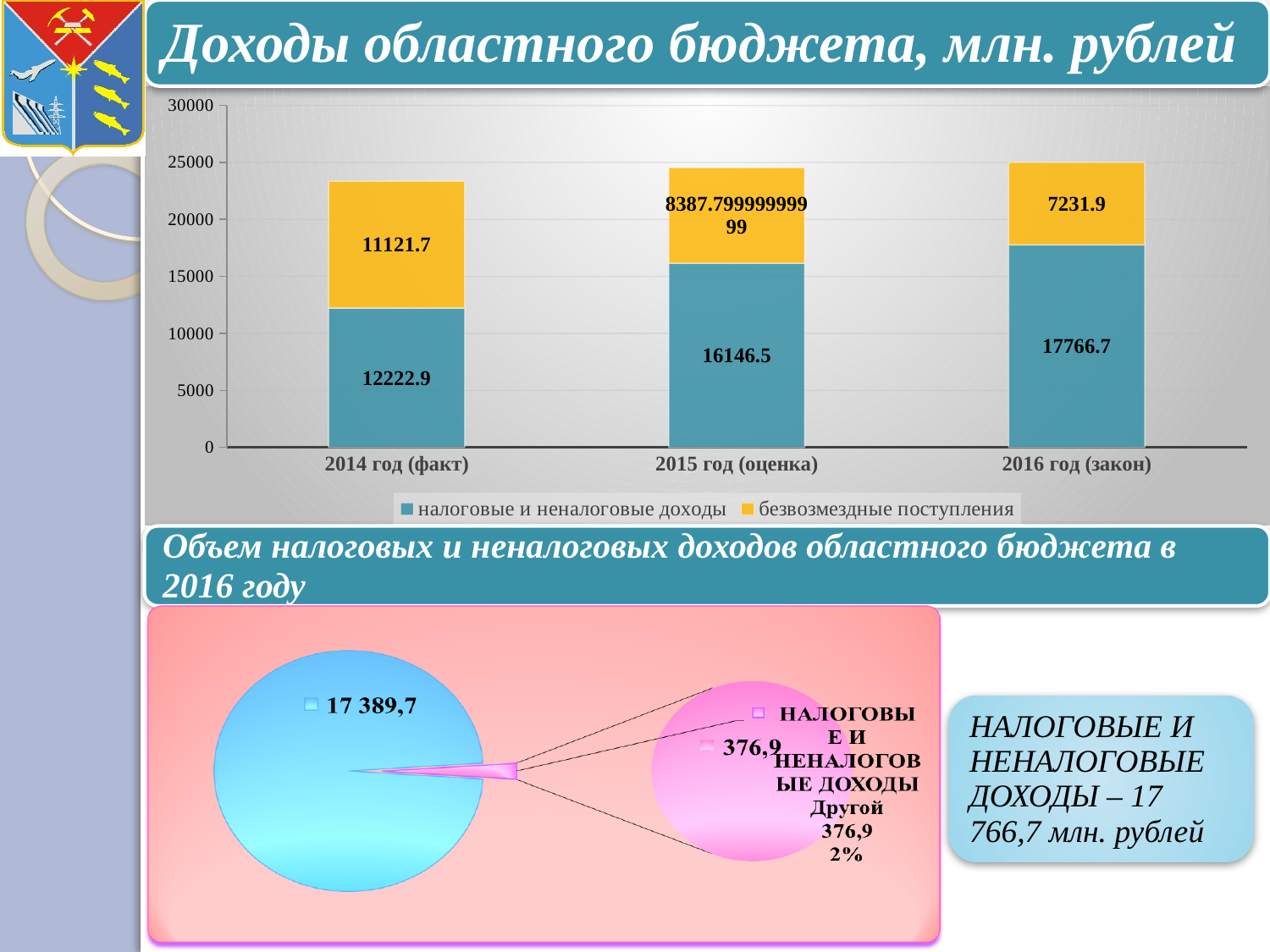
In the bar chart 'Доходы областного бюджета, млн. рублей', what is the value of безвозмездные поступления for 2016 год (закон)? 7231.9 In the pie chart 'Объем налоговых и неналоговых доходов областного бюджета в 2016 году', what share of the pie does the slice Другой represent? 2% In the bar chart 'Доходы областного бюджета, млн. рублей', what is the total of the stacked bar for 2014 год (факт)? 23344.6 In the bar chart 'Доходы областного бюджета, млн. рублей', how do the values of налоговые и неналоговые доходы change from 2014 to 2016? They rise In the bar chart 'Доходы областного бюджета, млн. рублей', what is the value of налоговые и неналоговые доходы for 2014 год (факт)? 12222.9 In the bar chart 'Доходы областного бюджета, млн. рублей', which year has the lowest value of безвозмездные поступления? 2016 год (закон) In the bar chart 'Доходы областного бюджета, млн. рублей', is безвозмездные поступления larger in 2014 год (факт) or in 2016 год (закон)? 2014 год (факт) How many series does the legend of the bar chart 'Доходы областного бюджета, млн. рублей' list? 2 In the pie chart 'Объем налоговых и неналоговых доходов областного бюджета в 2016 году', what is the value of the slice labelled Другой? 376,9 In the bar chart 'Доходы областного бюджета, млн. рублей', what is the value of налоговые и неналоговые доходы for 2015 год (оценка)? 16146.5 In the bar chart 'Доходы областного бюджета, млн. рублей', what is the difference between налоговые и неналоговые доходы in 2016 год (закон) and in 2014 год (факт)? 5543.8 In the bar chart 'Доходы областного бюджета, млн. рублей', which year has the highest value of налоговые и неналоговые доходы? 2016 год (закон)